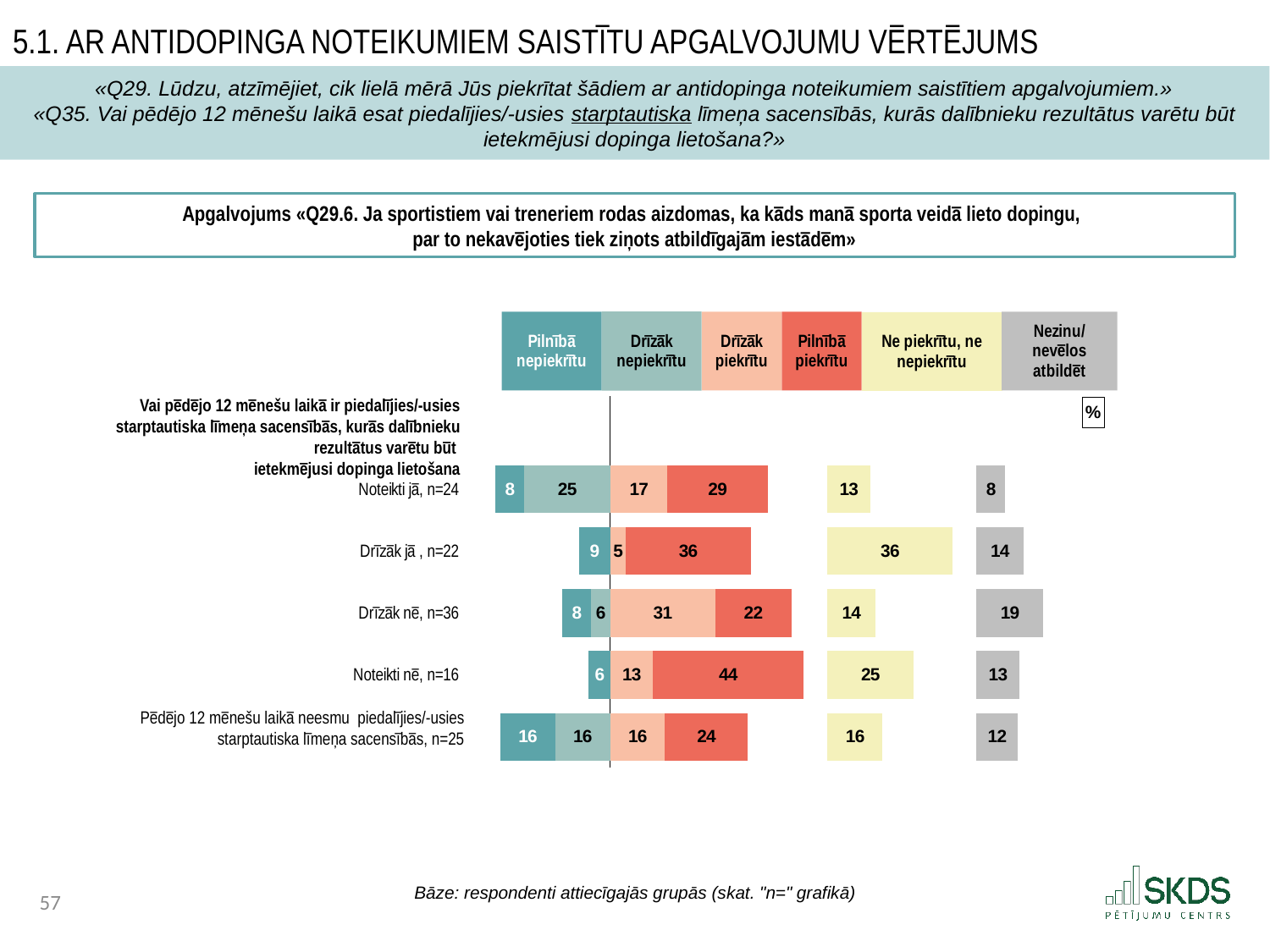
Which series is shown in grey in the legend? Nezinu/nevēlos atbildēt What is the difference between the "Drīzāk piekrītu" values for "Drīzāk nē, n=36" and "Noteikti jā, n=24"? 14 Which group has the lowest value for "Ne piekrītu, ne nepiekrītu"? Noteikti jā, n=24 Which group has the highest value for "Pilnībā piekrītu"? Noteikti nē, n=16 How many series does the legend list? 6 What is the value of "Drīzāk nepiekrītu" for the "Noteikti jā, n=24" group? 25 What is the value of "Nezinu/nevēlos atbildēt" for the "Drīzāk nē, n=36" group? 19 What is the value of "Pilnībā piekrītu" for the "Noteikti nē, n=16" group? 44 What is the value of "Ne piekrītu, ne nepiekrītu" for the "Drīzāk jā, n=22" group? 36 Which is larger: the "Pilnībā nepiekrītu" value for "Noteikti jā, n=24" or for the group that did not participate in international competitions (n=25)? The group that did not participate (n=25) How many categories (rows) are plotted in the chart? 5 What type of chart is shown on the slide? Stacked bar chart